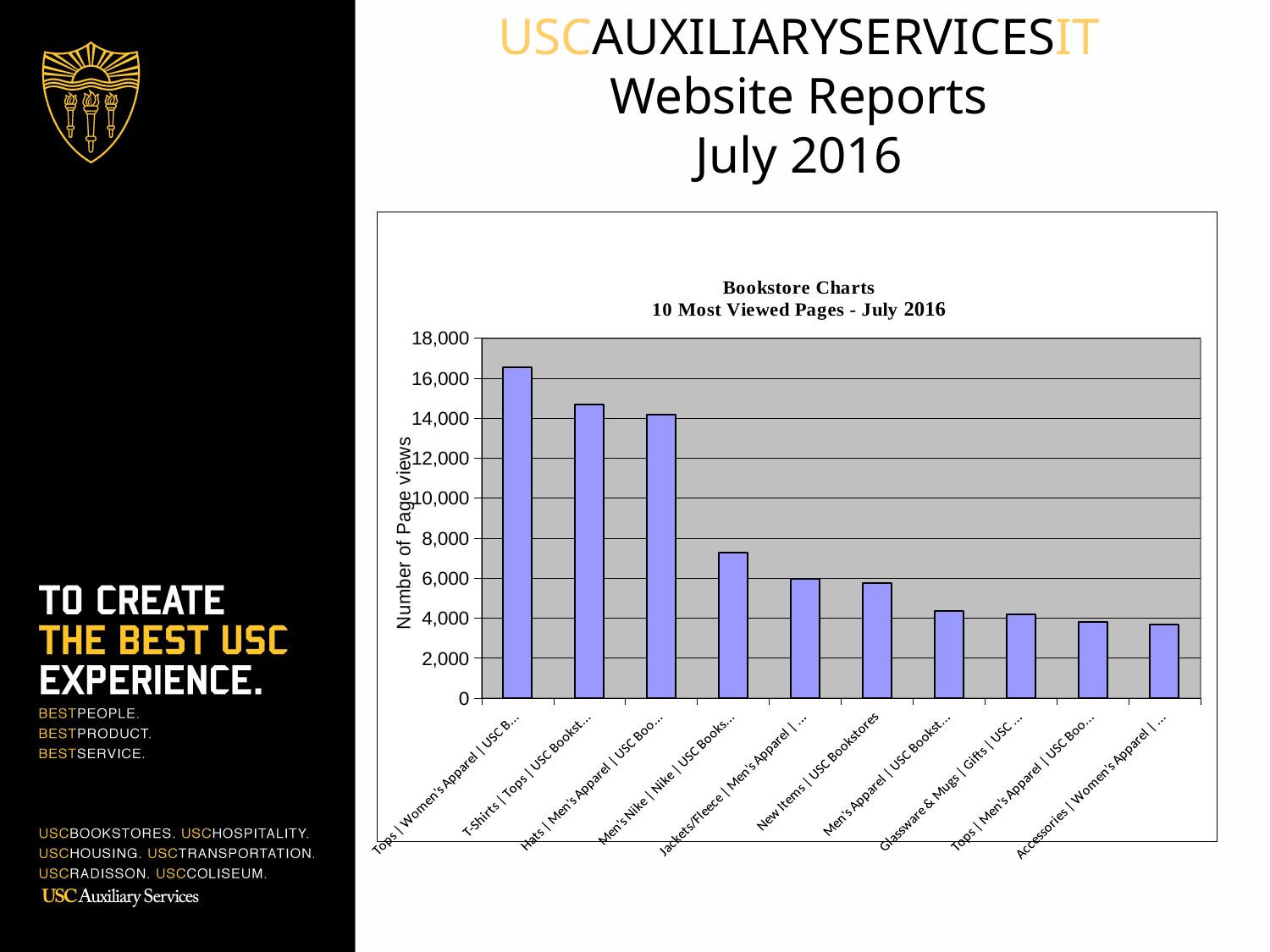
Is the value for Accessories | Women's Apparel greater or less than 4,000? less What is the title of the chart? Bookstore Charts 10 Most Viewed Pages - July 2016 Which has more page views, Men's Nike | Nike or New Items | USC Bookstores? Men's Nike | Nike What kind of chart is shown on the slide? Bar chart Do the page view values rise or fall moving from left to right along the x axis? Fall Is the value for Tops | Women's Apparel greater or less than 14,000? greater Is the value for Jackets/Fleece | Men's Apparel greater or less than 8,000? less How many bars (pages) are plotted in the chart? 10 Which page has the lowest number of page views? Accessories | Women's Apparel | ... Which page has the highest number of page views? Tops | Women's Apparel | USC B... What is the label on the vertical axis of the chart? Number of Page views